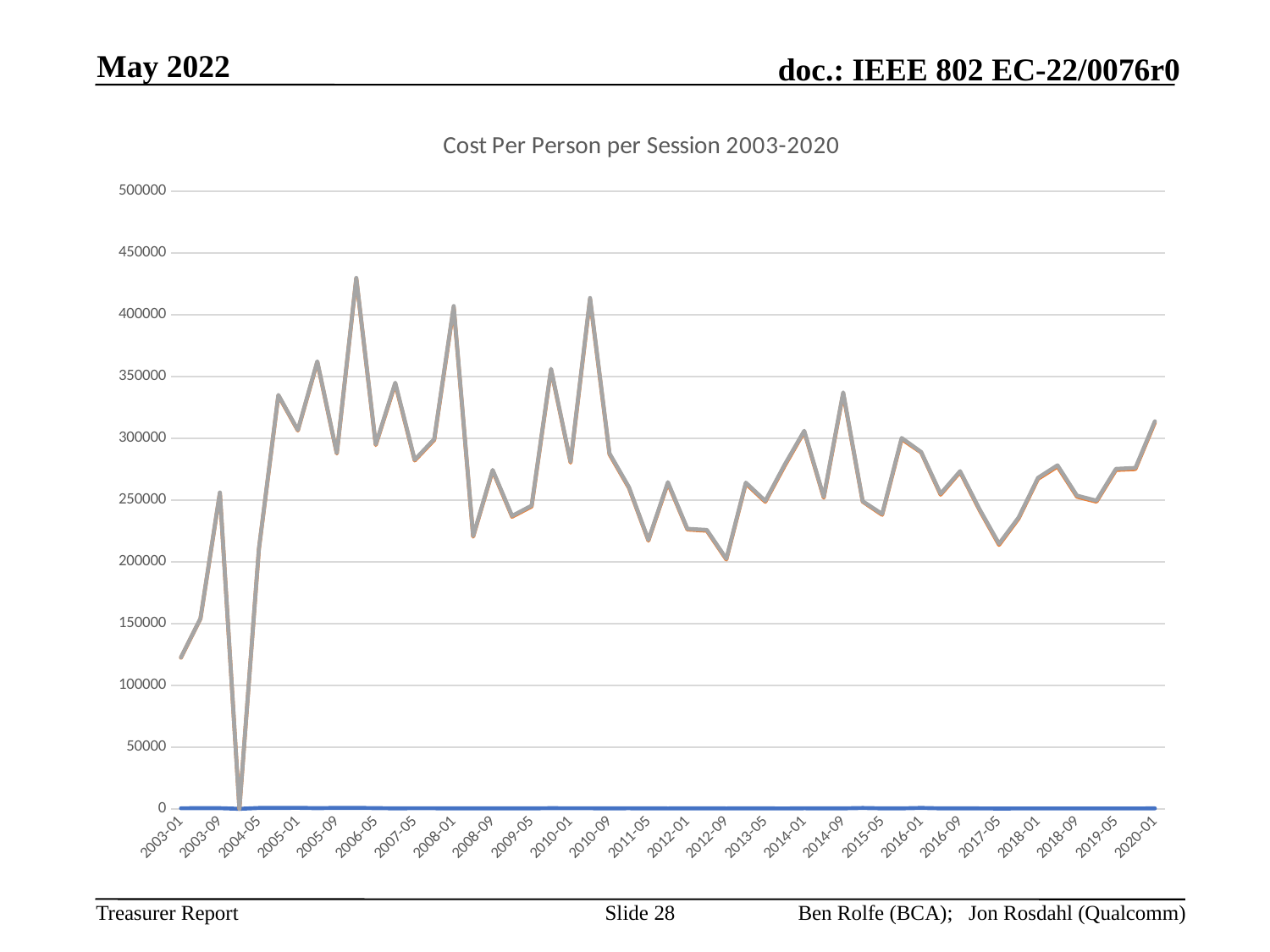
Is the value for 2003-01 greater or less than 150000? less Is the value for 2003-09 greater or less than 200000? greater Which is larger, the value at 2003-01 or the value at 2003-09? 2003-09 Is the lowest point of the gray line greater or less than 50000? less What kind of chart is shown on the slide? Line chart What is the title of the chart? Cost Per Person per Session 2003-2020 Which is larger, the value at 2003-01 or the value at 2020-01? 2020-01 What is the highest value shown on the vertical axis? 500000 Between 2003-01 and 2003-09, does the gray line rise or fall? rise